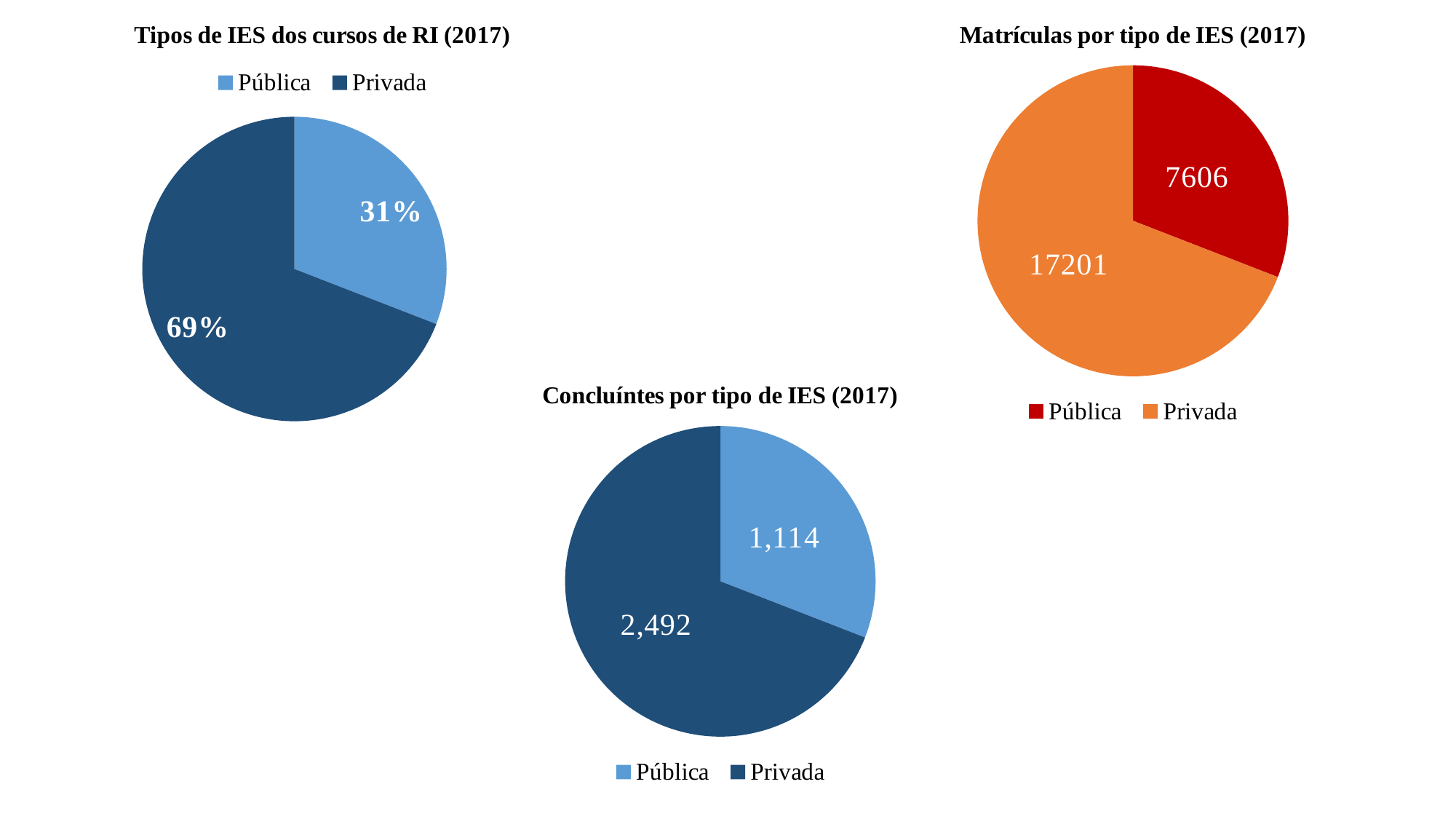
In the chart 'Matrículas por tipo de IES (2017)', which category has the largest slice? Privada In the chart 'Concluíntes por tipo de IES (2017)', what is the value for Privada? 2,492 How many categories does the legend of the chart 'Concluíntes por tipo de IES (2017)' list? 2 In the chart 'Tipos de IES dos cursos de RI (2017)', what share of the pie is Privada? 69% In the chart 'Concluíntes por tipo de IES (2017)', what is the difference between the Privada and Pública values? 1,378 In the chart 'Matrículas por tipo de IES (2017)', what is the difference between the Privada and Pública values? 9595 In the chart 'Matrículas por tipo de IES (2017)', what is the value for Privada? 17201 In the chart 'Concluíntes por tipo de IES (2017)', what is the value for Pública? 1,114 In the chart 'Concluíntes por tipo de IES (2017)', which category has the smallest slice? Pública What type of chart is 'Matrículas por tipo de IES (2017)'? Pie chart In the chart 'Tipos de IES dos cursos de RI (2017)', what share of the pie is Pública? 31% In the chart 'Matrículas por tipo de IES (2017)', what is the value for Pública? 7606